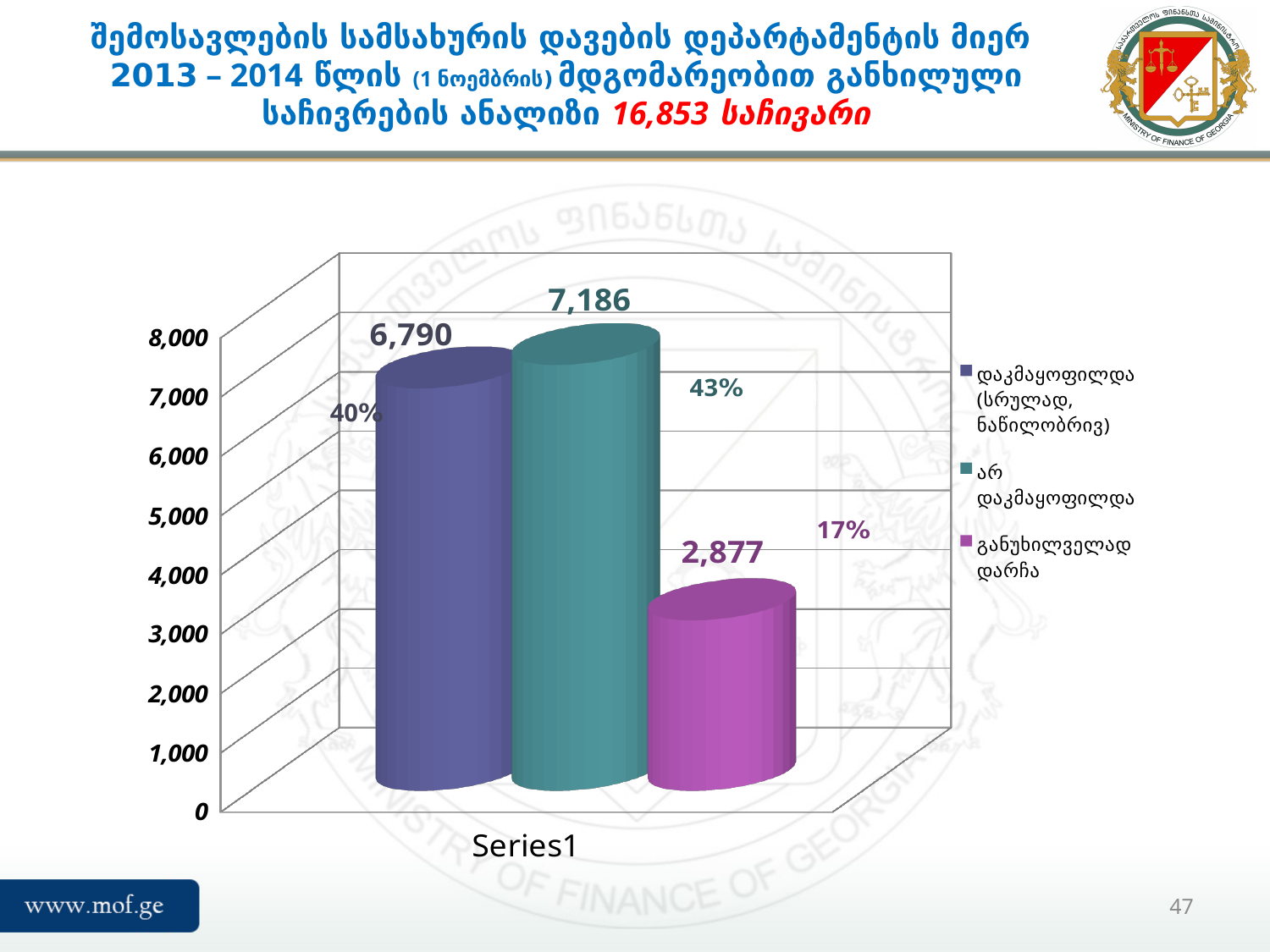
Which category has the lowest value? განუხილველად დარჩა What is the value for "დაკმაყოფილდა (სრულად, ნაწილობრივ)"? 6,790 Which is larger: the value for "დაკმაყოფილდა (სრულად, ნაწილობრივ)" or the value for "განუხილველად დარჩა"? დაკმაყოფილდა (სრულად, ნაწილობრივ) What is the value for "განუხილველად დარჩა"? 2,877 What is the difference between the values for "არ დაკმაყოფილდა" and "დაკმაყოფილდა (სრულად, ნაწილობრივ)"? 396 Which category has the highest value? არ დაკმაყოფილდა How many series does the legend list? 3 What kind of chart is shown on the slide? bar chart What is the value for "არ დაკმაყოფილდა"? 7,186 What percentage is shown next to the "არ დაკმაყოფილდა" bar? 43% Is the value for "განუხილველად დარჩა" greater or less than 3,000? less What is the label shown on the horizontal axis of the chart? Series1